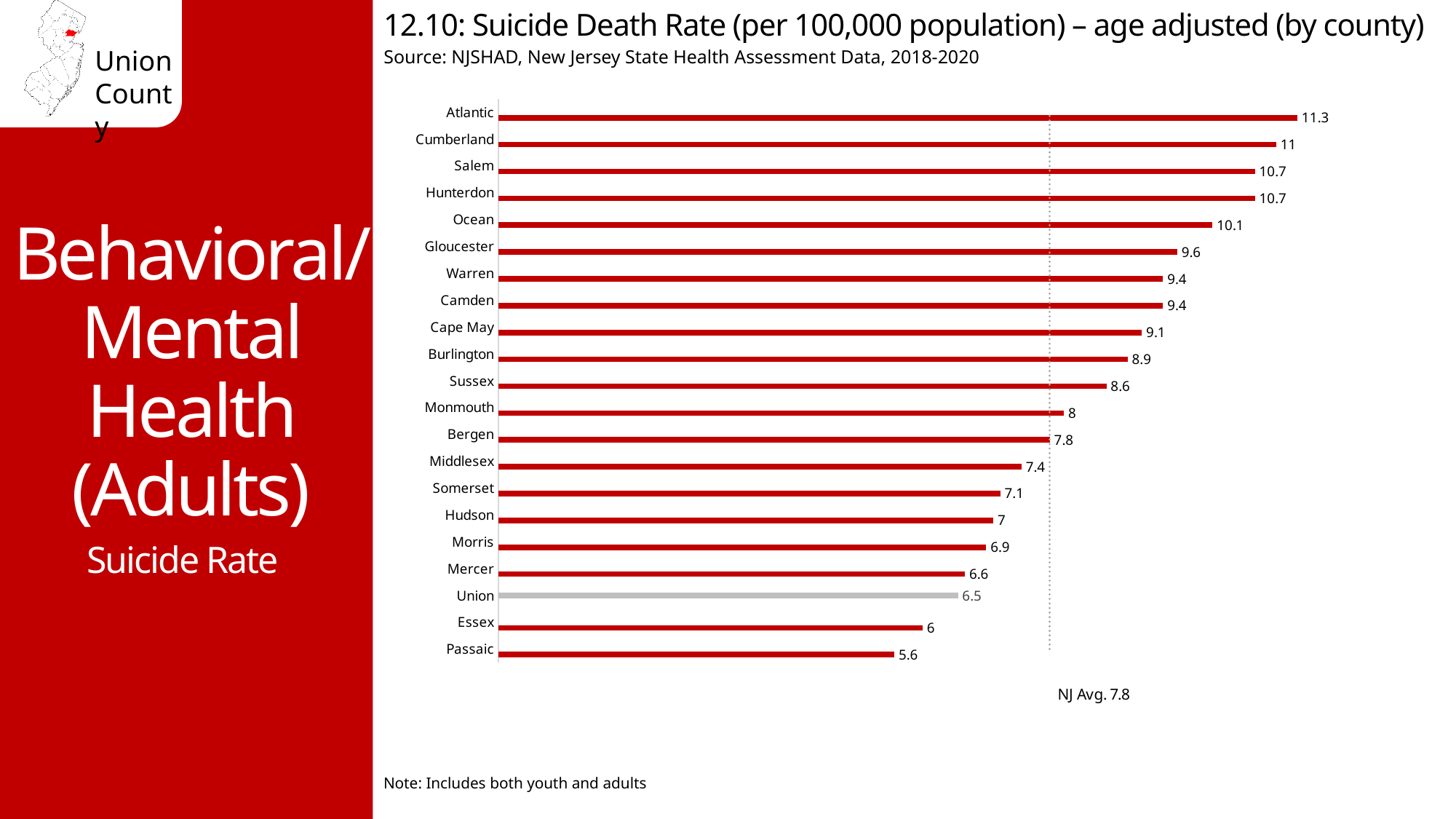
What is the difference between the suicide death rate of Union County and the NJ average of 7.8? 1.3 What is the NJ average suicide death rate indicated by the dotted line? 7.8 Which county has the lowest suicide death rate? Passaic What is the difference between the suicide death rates of Atlantic and Passaic counties? 5.7 What is the suicide death rate for Atlantic County? 11.3 How many counties are shown in the chart? 21 What type of chart is shown on the slide? Bar chart Which county has a higher suicide death rate, Essex or Union? Union What is the suicide death rate for Monmouth County? 8 Which county has the highest suicide death rate? Atlantic Which county has a higher suicide death rate, Ocean or Gloucester? Ocean What is the suicide death rate for Union County? 6.5